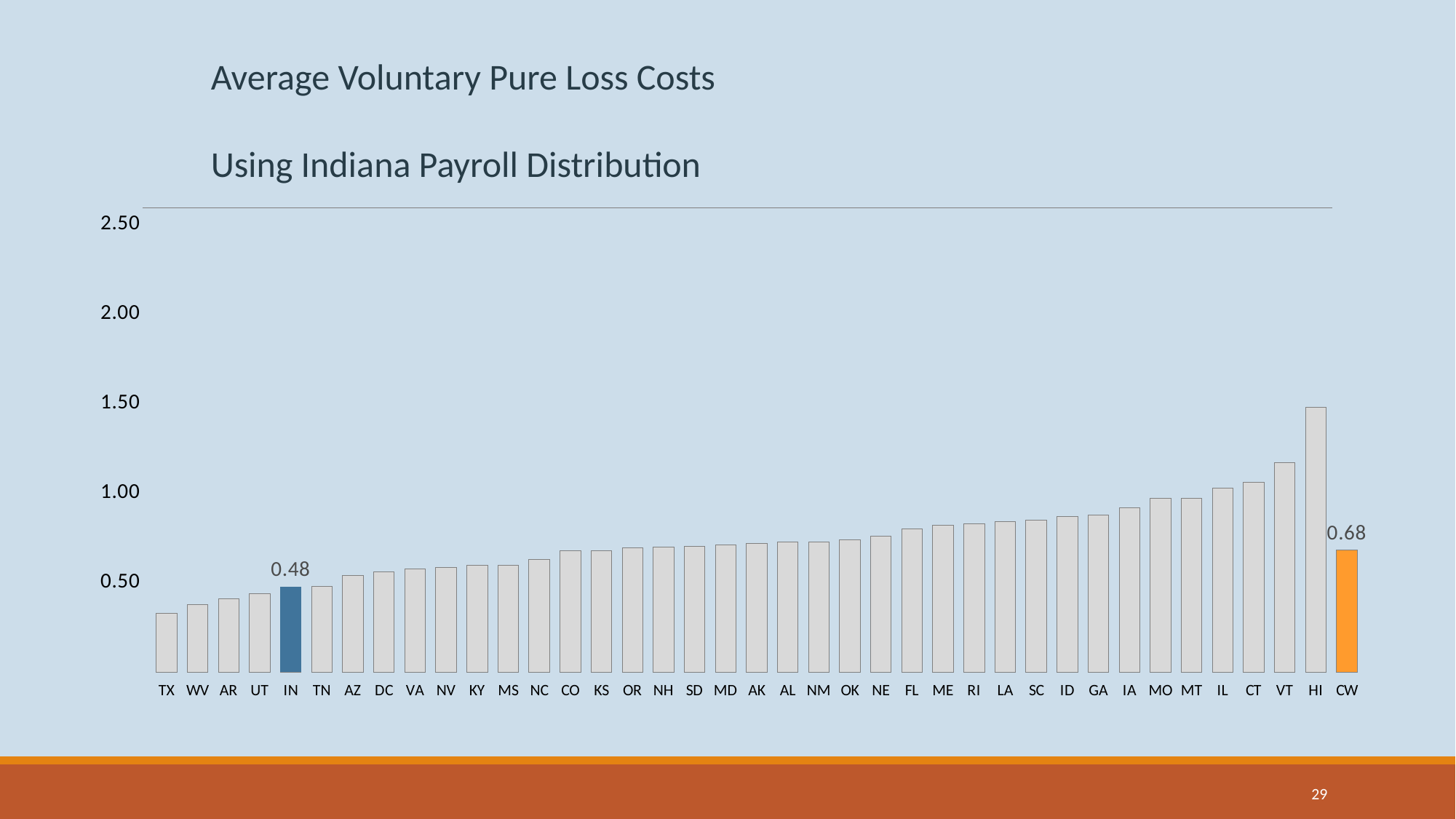
Is the value for TX greater or less than 0.50? less What is the difference between the values for CW and IN? 0.20 Which category has the lowest value? TX Is the value for VT greater or less than 1.00? greater What kind of chart is shown on the slide? bar chart What is the value for IN? 0.48 How many categories are shown on the x axis? 39 Do the values generally rise or fall from TX to HI along the x axis? rise Which category has the highest value? HI Is the value for HI greater or less than 1.00? greater Which is larger, the value for CW or the value for IN? CW What is the value for CW? 0.68